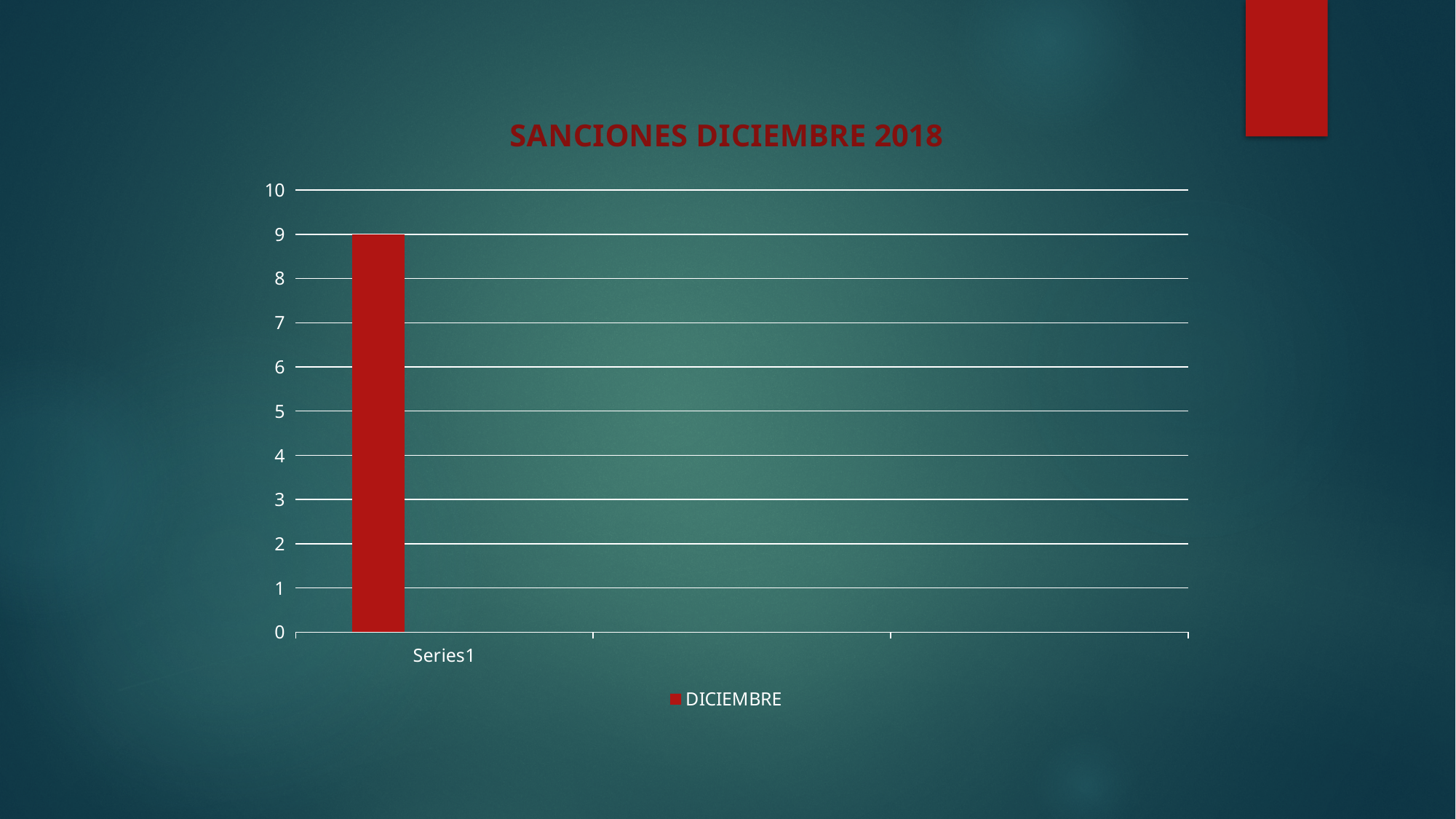
What series name appears in the legend? DICIEMBRE Is the value for Series1 greater or less than 10? less What is the title of the chart? SANCIONES DICIEMBRE 2018 What is the label of the category on the horizontal axis? Series1 How many bars are plotted in the chart? 1 Is the value for Series1 greater or less than 5? greater What is the maximum value shown on the vertical axis? 10 What kind of chart is shown on the slide? bar chart What is the value of the DICIEMBRE bar for Series1? 9 How many series does the legend list? 1